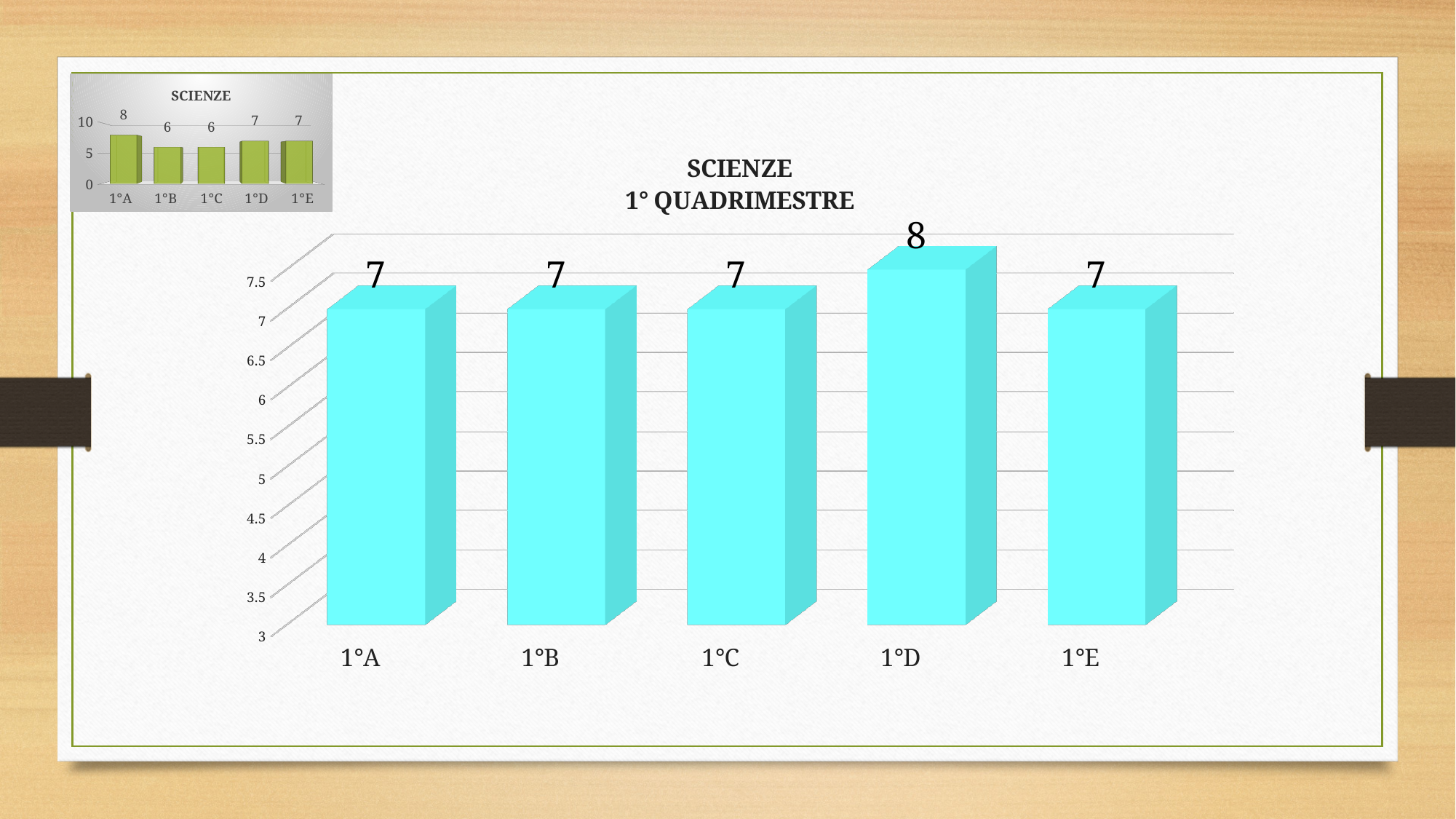
In the large chart titled SCIENZE 1° QUADRIMESTRE, what is the value for 1°A? 7 What is the title of the large chart on the slide? SCIENZE 1° QUADRIMESTRE What kind of chart is the large chart titled SCIENZE 1° QUADRIMESTRE? bar chart In the small chart at the top left titled SCIENZE, what is the difference between the values for 1°A and 1°C? 2 In the large chart titled SCIENZE 1° QUADRIMESTRE, what is the value for 1°D? 8 In the small chart at the top left titled SCIENZE, what is the value for 1°B? 6 In the small chart at the top left titled SCIENZE, which category has the highest value? 1°A In the large chart titled SCIENZE 1° QUADRIMESTRE, what is the difference between the values for 1°D and 1°E? 1 In the large chart titled SCIENZE 1° QUADRIMESTRE, which is larger, the value for 1°D or the value for 1°B? 1°D In the large chart titled SCIENZE 1° QUADRIMESTRE, which category has the highest value? 1°D In the small chart at the top left titled SCIENZE, what is the value for 1°A? 8 In the large chart titled SCIENZE 1° QUADRIMESTRE, how many categories are shown on the x axis? 5